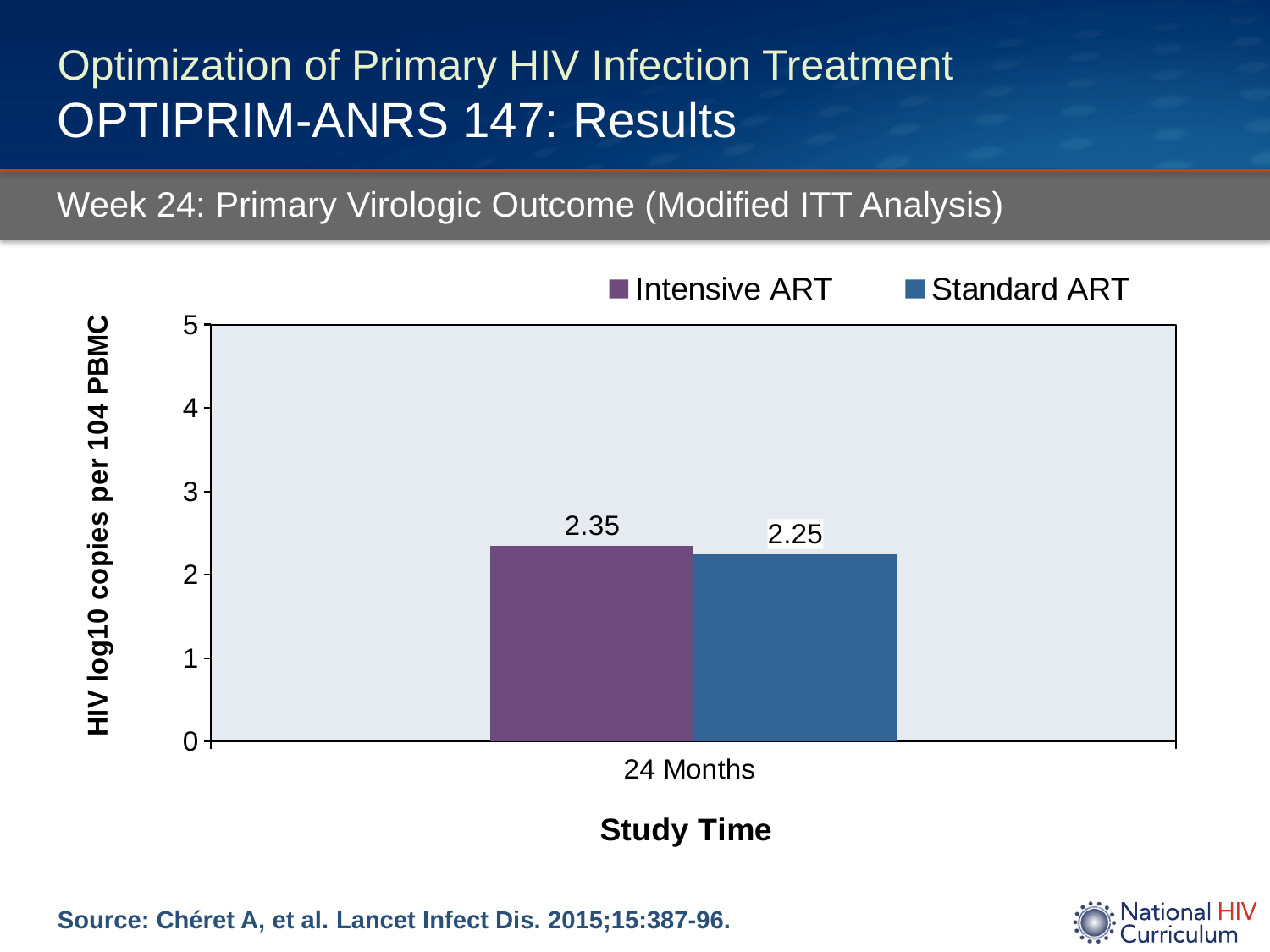
What is the difference between the Intensive ART and Standard ART values at 24 Months? 0.10 What is the value for Standard ART at 24 Months? 2.25 How many categories are shown on the x axis? 1 What is the label of the x axis? Study Time Is the value for Standard ART at 24 Months greater or less than 2? greater Which series has the higher value at 24 Months, Intensive ART or Standard ART? Intensive ART What is the label of the y axis? HIV log10 copies per 104 PBMC What is the maximum value shown on the y axis? 5 What kind of chart is shown on the slide? Bar chart Is the value for Intensive ART at 24 Months greater or less than 3? less How many series does the legend list? 2 What is the value for Intensive ART at 24 Months? 2.35